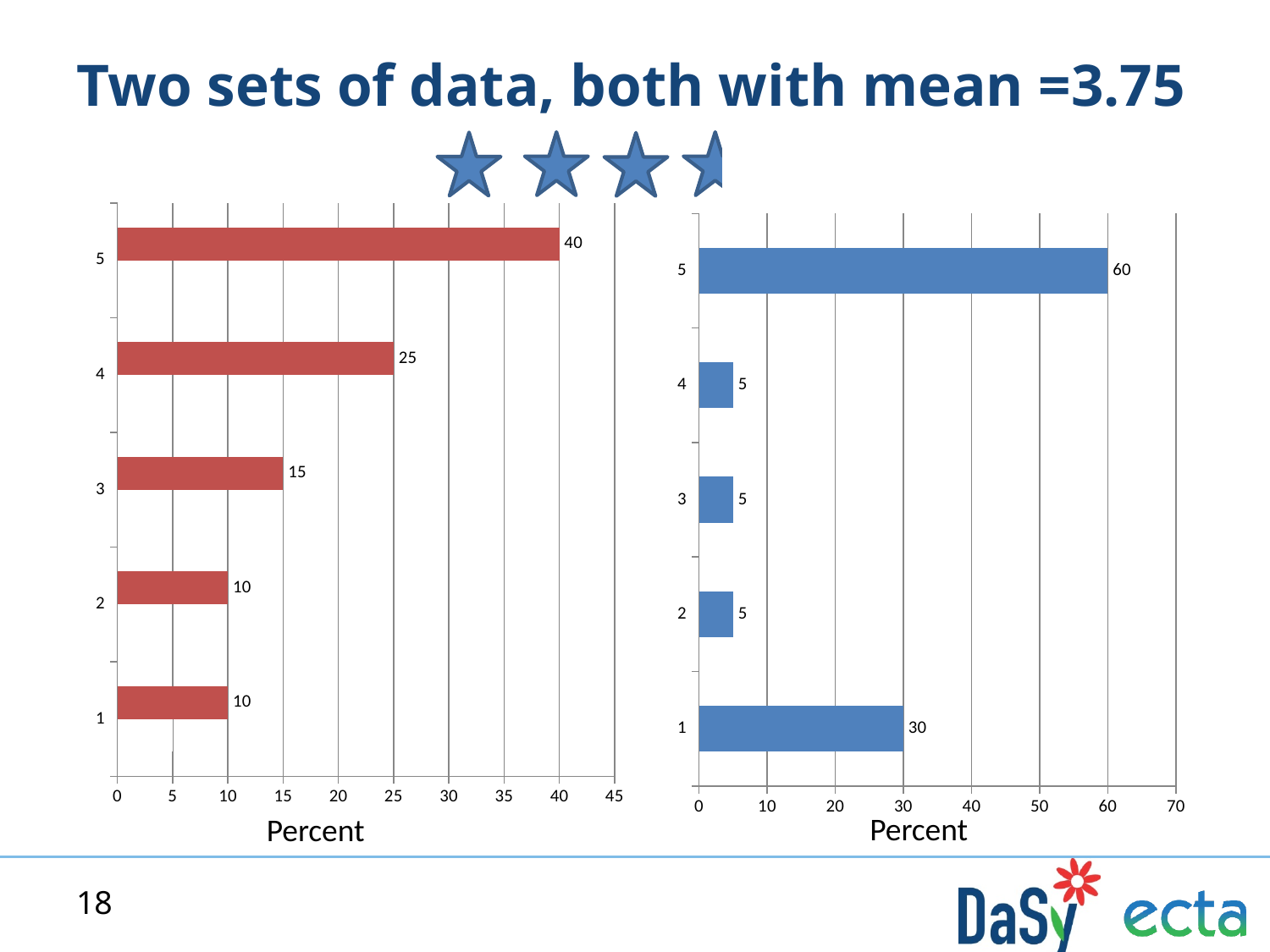
In the left chart, do the values rise or fall as the category number increases from 1 to 5? rise What is the x-axis label on the right chart? Percent In the right chart, what is the value for category 1? 30 In the right chart, what is the difference between the values for category 5 and category 1? 30 In the left chart, what is the difference between the values for category 5 and category 4? 15 In the left chart, what is the value for category 3? 15 In the left chart, what is the value for category 5? 40 In the left chart, which category has the lowest value, 3 or 4? 3 How many categories are shown in the right chart? 5 What kind of chart is the left chart? bar chart In the left chart, is the value for category 4 greater or less than 20? greater In the right chart, which category has the highest value? 5